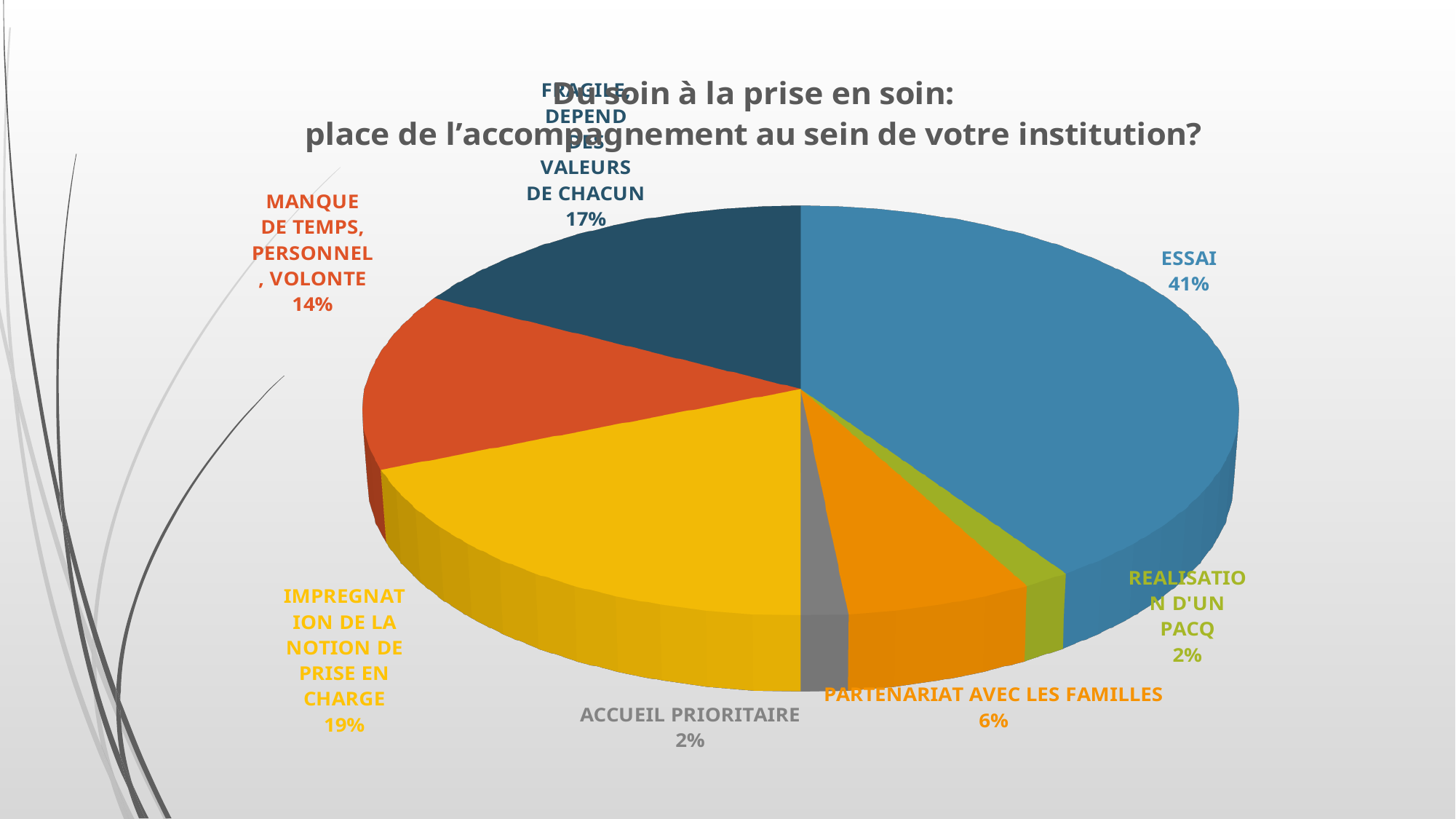
What percentage is shown for IMPREGNATION DE LA NOTION DE PRISE EN CHARGE? 19% What percentage is shown for ACCUEIL PRIORITAIRE? 2% What percentage is shown for FRAGILE, DEPEND DES VALEURS DE CHACUN? 17% What colour is the ESSAI slice? Blue What is the difference in percentage points between ESSAI and IMPREGNATION DE LA NOTION DE PRISE EN CHARGE? 22 Which is larger, the slice for FRAGILE, DEPEND DES VALEURS DE CHACUN or the slice for MANQUE DE TEMPS, PERSONNEL, VOLONTE? FRAGILE, DEPEND DES VALEURS DE CHACUN What percentage is shown for PARTENARIAT AVEC LES FAMILLES? 6% What kind of chart is shown on the slide? Pie chart Which category has the largest slice of the pie? ESSAI How many slices does the pie chart have? 7 What percentage is shown for MANQUE DE TEMPS, PERSONNEL, VOLONTE? 14% What share of the pie does ESSAI represent? 41%